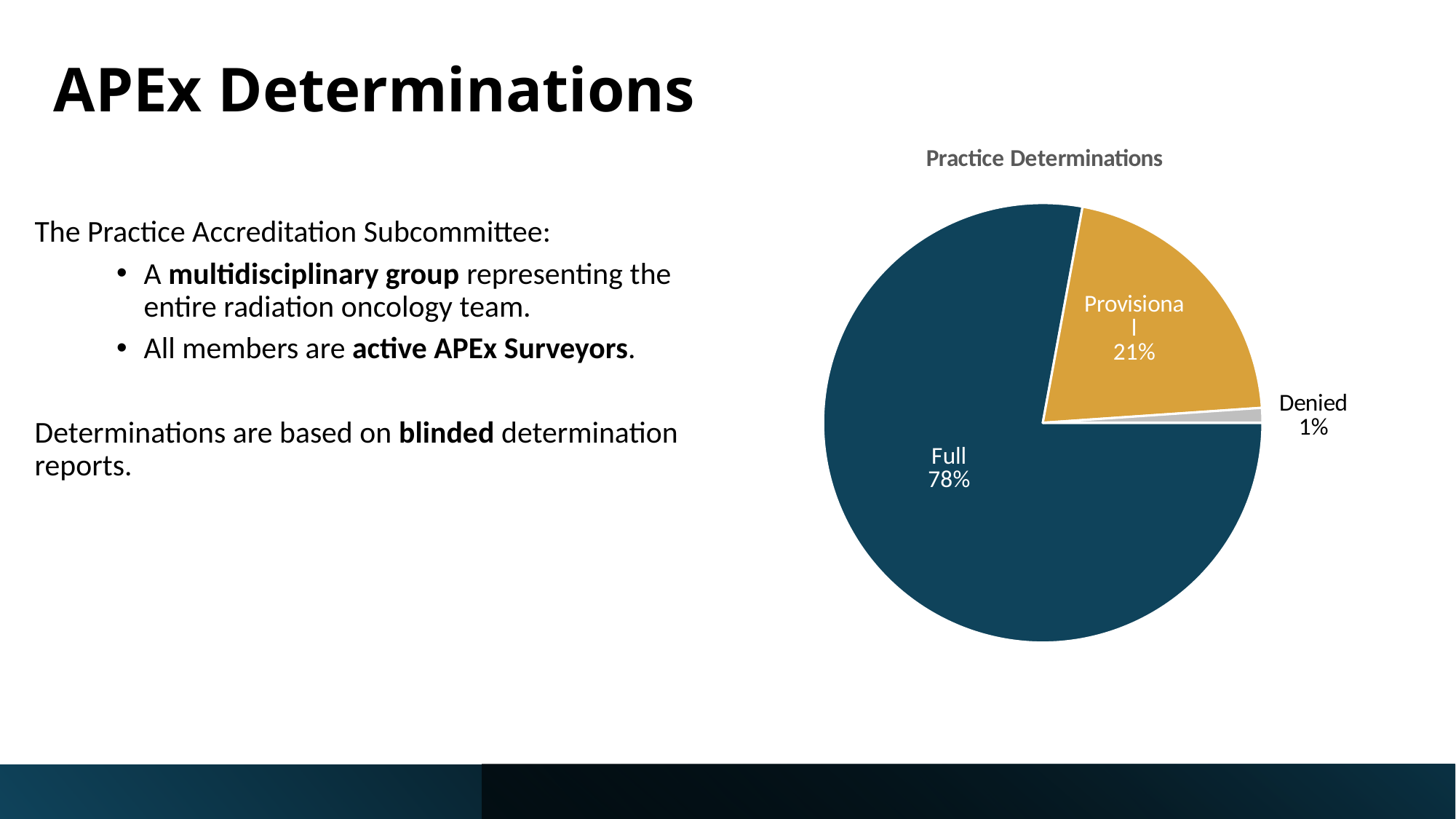
What share of the pie does the Full slice represent? 78% What is the difference in percentage points between the Full and Provisional slices? 57 What is the difference in percentage points between the Provisional and Denied slices? 20 What share of the pie does the Denied slice represent? 1% Which is larger, the Provisional slice or the Denied slice? Provisional What type of chart is shown on the slide? pie chart What share of the pie does the Provisional slice represent? 21% How many slices does the pie chart have? 3 What is the title of the chart? Practice Determinations What colour is the Provisional slice? gold/orange Which category has the smallest slice of the pie? Denied Which category has the largest slice of the pie? Full